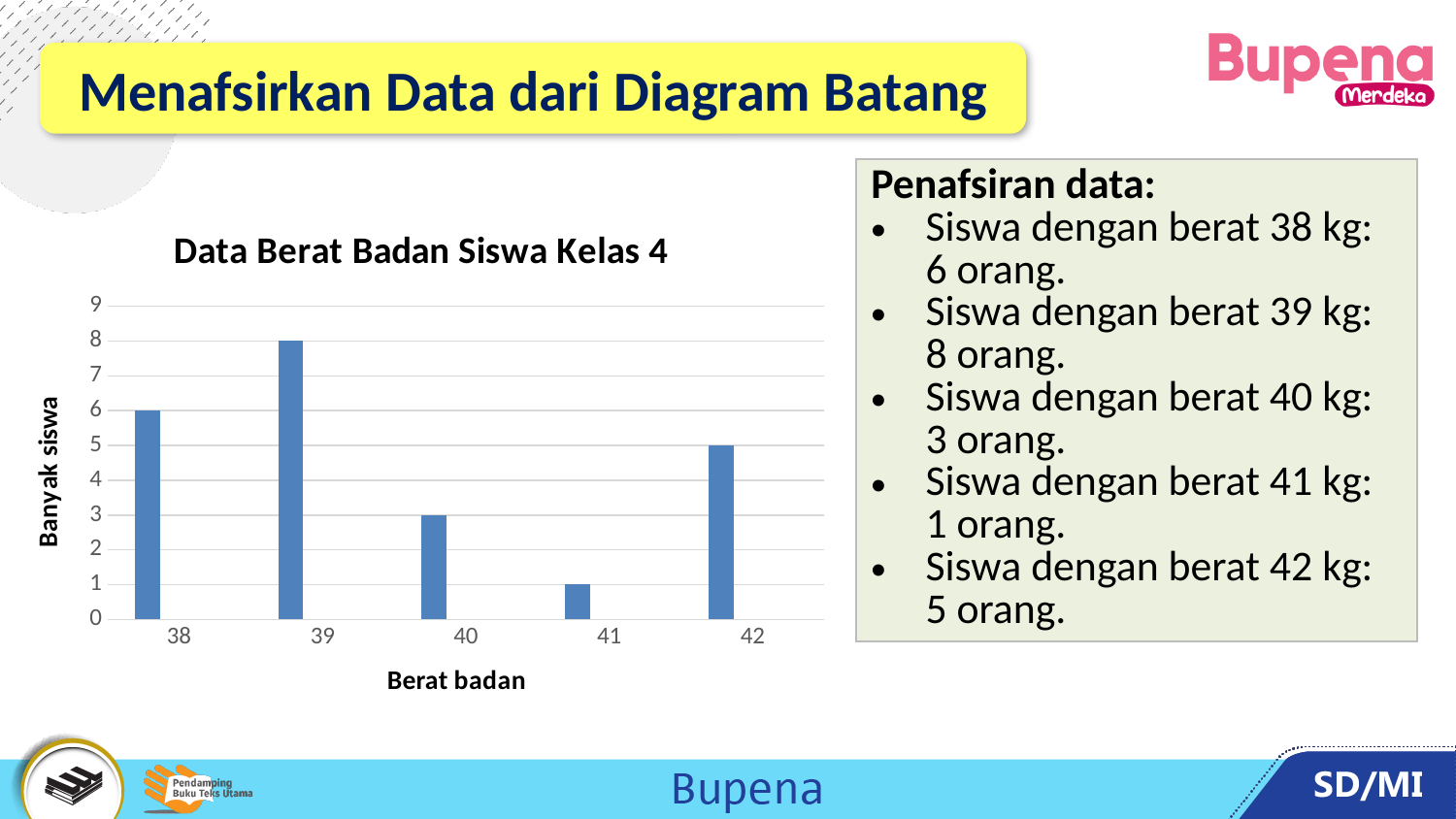
Which has more students: the 38 kg category or the 42 kg category? 38 How many weight categories are shown on the x axis? 5 What type of chart is shown on the slide? Bar chart What is the label of the y axis? Banyak siswa Which weight category has the highest number of students? 39 What is the title of the chart? Data Berat Badan Siswa Kelas 4 Which weight category has the lowest number of students? 41 How many students (Banyak siswa) have a weight of 38 kg according to the chart? 6 What is the difference between the number of students weighing 39 kg and those weighing 40 kg? 5 What is the value of the bar for Berat badan 41? 1 What is the value of the bar for Berat badan 39? 8 Is the value for Berat badan 42 greater or less than 4? greater